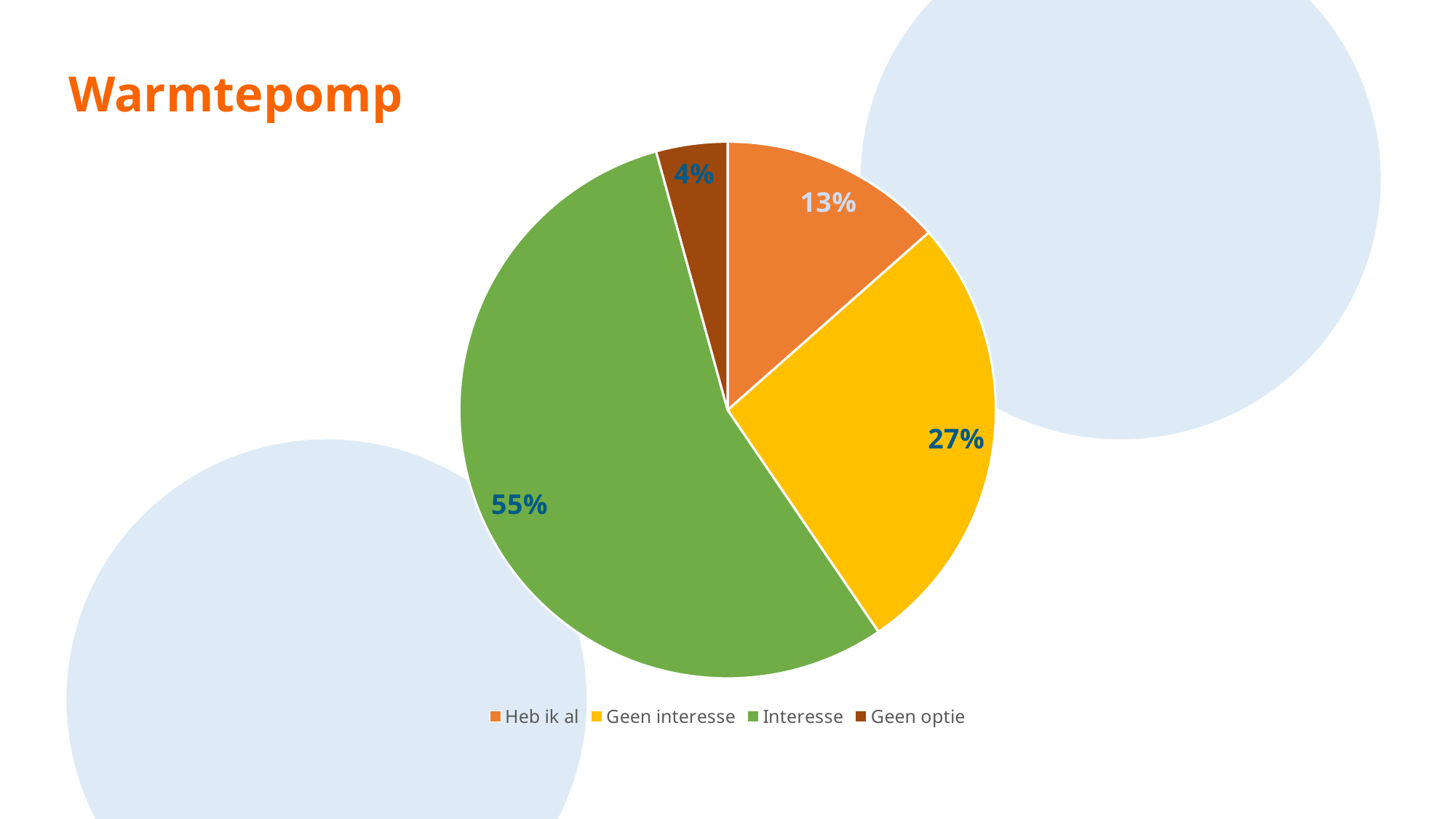
Which category has the smallest slice of the pie? Geen optie What percentage of the pie is labelled "Heb ik al"? 13% What is the difference in percentage points between "Interesse" and "Geen interesse"? 28 What percentage of the pie is labelled "Geen optie"? 4% Which category has the largest slice of the pie? Interesse How many entries does the legend list? 4 What is the title of the slide containing the pie chart? Warmtepomp Which is larger, the slice for "Heb ik al" or the slice for "Geen interesse"? Geen interesse What percentage of the pie is labelled "Interesse"? 55% What kind of chart is shown on the slide? pie chart How many slices does the pie chart have? 4 What percentage of the pie is labelled "Geen interesse"? 27%